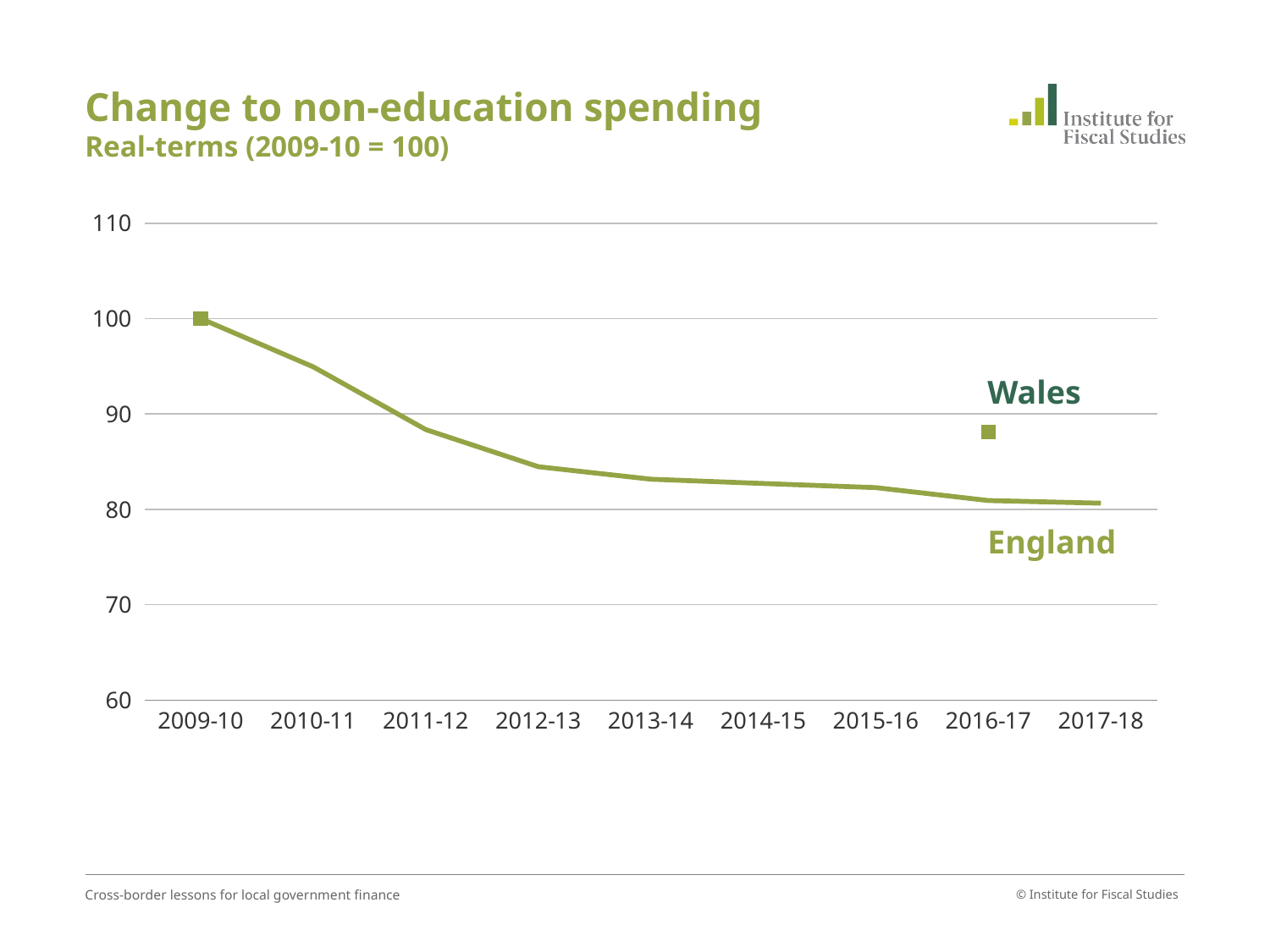
In which year is the England value highest? 2009-10 Is the value for England in 2017-18 greater or less than 90? less What kind of chart is shown on the slide? line chart Is the value for England in 2011-12 greater or less than 90? less Which two areas are plotted on the chart? England and Wales What is the title of the chart? Change to non-education spending What is the index value for England in 2009-10? 100 Does the England line rise or fall from 2009-10 to 2017-18? fall Is the value for England in 2012-13 greater or less than 80? greater How many financial years are shown on the x axis? 9 In 2016-17, which is higher, the value for Wales or the value for England? Wales